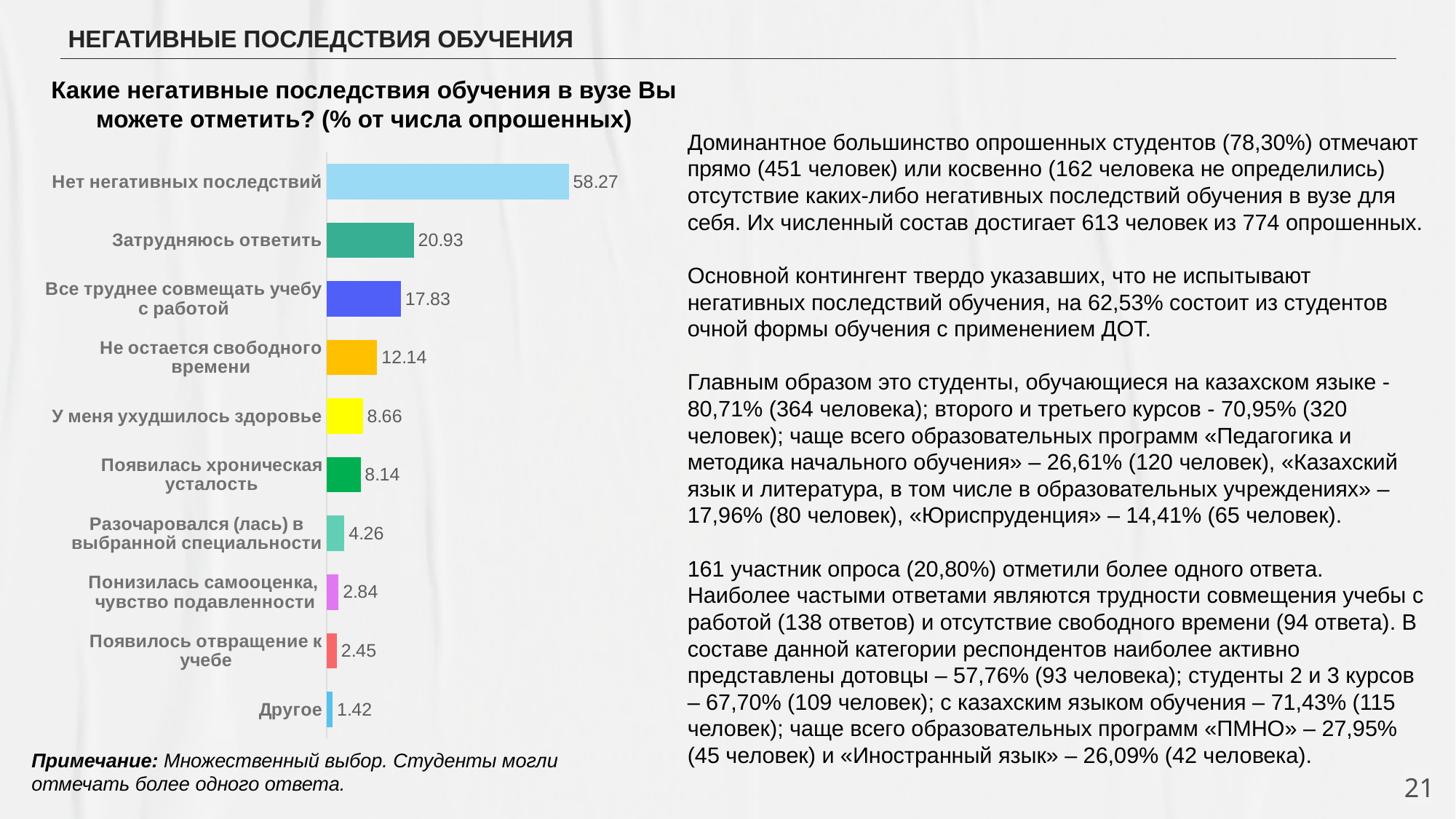
What is the difference between the values for "Затрудняюсь ответить" and "Все труднее совмещать учебу с работой"? 3.1 What kind of chart is shown on the slide? Bar chart What is the value for "Появилось отвращение к учебе"? 2.45 Which category has the lowest value? Другое What is the value for "У меня ухудшилось здоровье"? 8.66 How many categories are shown in the chart? 10 Which is larger: the value for "Не остается свободного времени" or the value for "Появилась хроническая усталость"? Не остается свободного времени Which category has the highest value? Нет негативных последствий What is the difference between the values for "Разочаровался (лась) в выбранной специальности" and "Понизилась самооценка, чувство подавленности"? 1.42 What colour is the bar for "У меня ухудшилось здоровье"? Yellow What is the value for "Все труднее совмещать учебу с работой"? 17.83 What is the value for "Нет негативных последствий"? 58.27